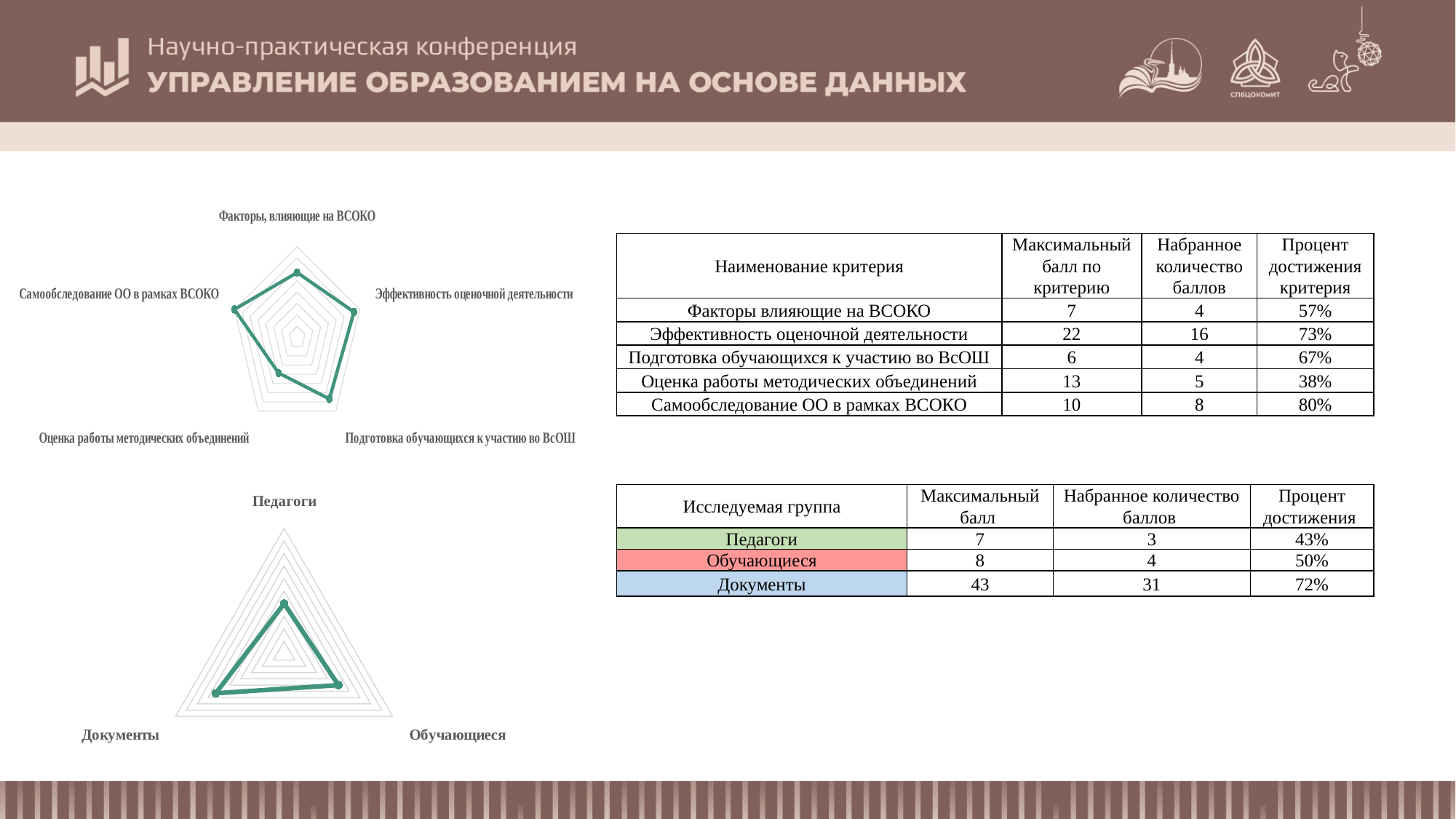
According to the table next to the upper radar chart, what is the percentage for Самообследование ОО в рамках ВСОКО? 80% According to the table next to the lower radar chart, what is the percentage for Документы? 72% In the lower radar chart, which category has the lowest value? Педагоги In the upper radar chart, which category has the lowest value? Оценка работы методических объединений In the upper radar chart, which category has the highest value? Самообследование ОО в рамках ВСОКО What kind of chart is the upper chart on the left of the slide? Radar chart What kind of chart is the lower chart on the left of the slide? Radar chart How many categories (axes) does the lower radar chart have? 3 In the upper radar chart, which is larger: the value for Эффективность оценочной деятельности or the value for Оценка работы методических объединений? Эффективность оценочной деятельности In the lower radar chart, which is larger: the value for Документы or the value for Обучающиеся? Документы How many categories (axes) does the upper radar chart have? 5 In the lower radar chart, which category has the highest value? Документы